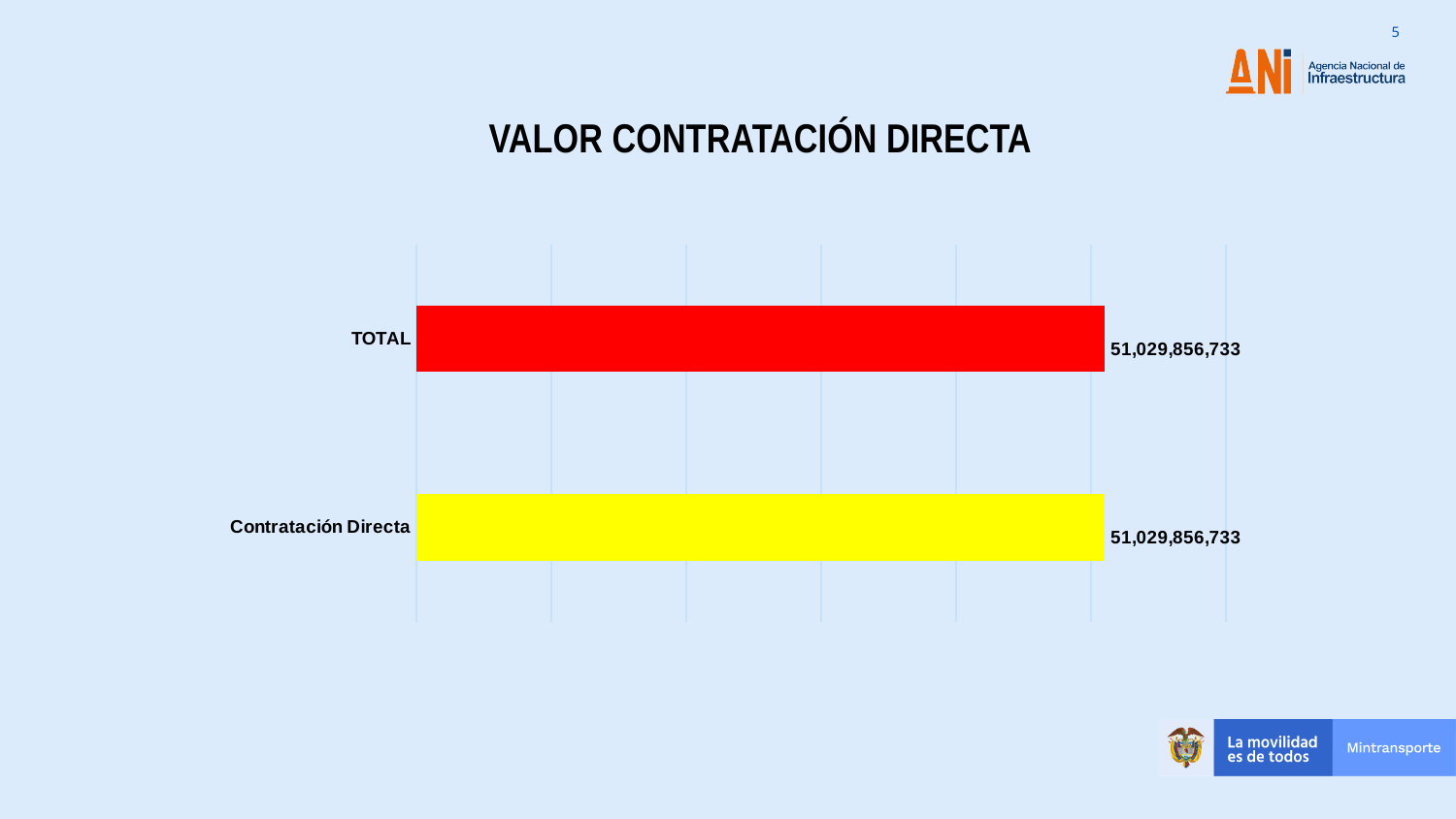
What colour is the bar for TOTAL? Red What is the difference between the value for TOTAL and the value for Contratación Directa? 0 What is the value for TOTAL? 51,029,856,733 What is the title of the chart? VALOR CONTRATACIÓN DIRECTA Are the values for TOTAL and Contratación Directa equal? Yes What is the value for Contratación Directa? 51,029,856,733 What kind of chart is shown on the slide? Bar chart How many categories are shown in the chart? 2